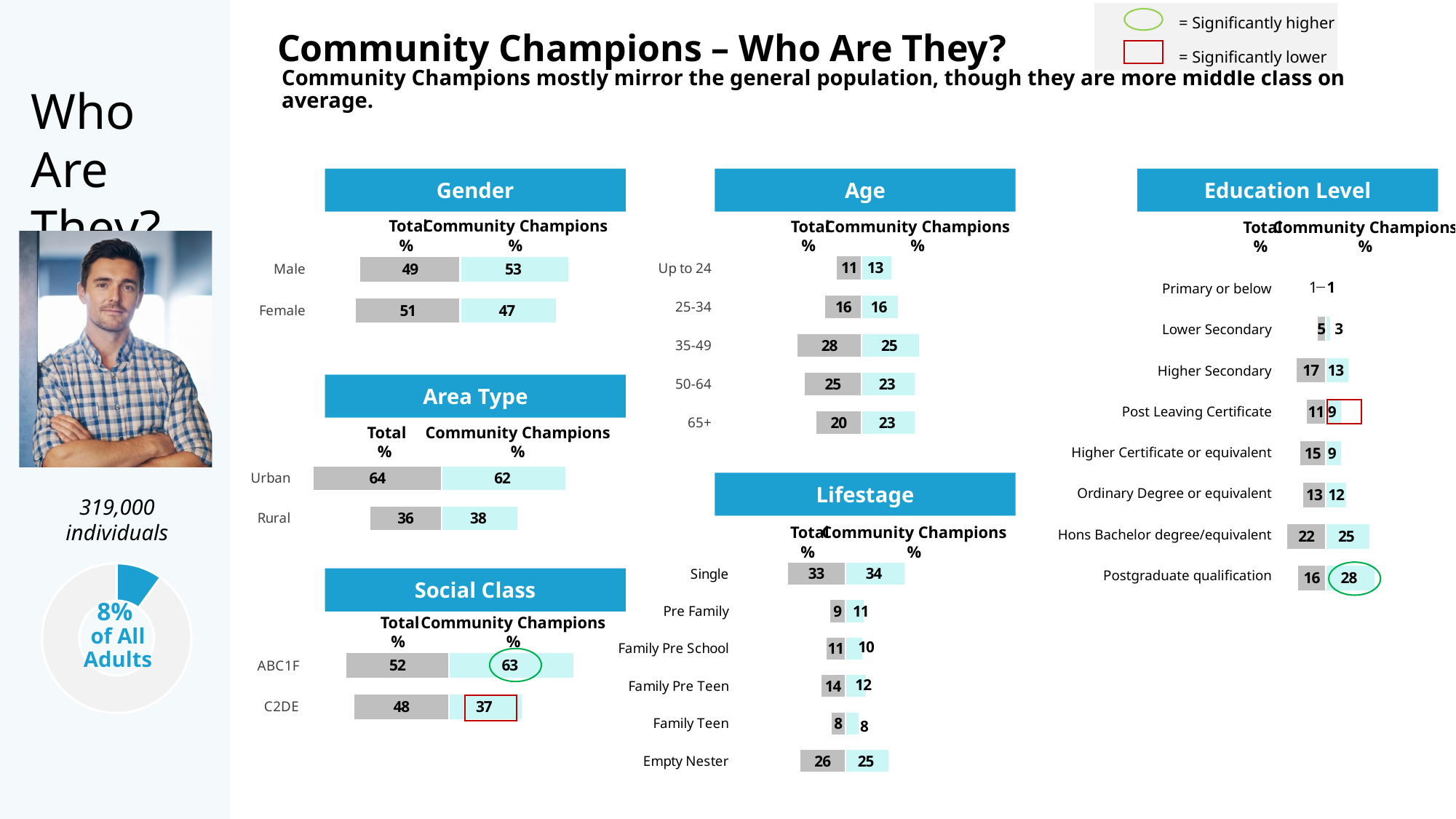
In the Education Level chart, which education level has the highest Community Champions %? Postgraduate qualification In the Lifestage chart, which lifestage has the lowest Total %? Family Teen In the Age chart, which age group has the highest Total %? 35-49 In the Lifestage chart, what is the Community Champions % for Empty Nester? 25 In the Area Type chart, what is the Total % for Urban? 64 In the Education Level chart, what is the Community Champions % for Postgraduate qualification? 28 In the Social Class chart, what is the difference between the Community Champions % and the Total % for ABC1F? 11 In the Social Class chart, which is larger for C2DE: the Total % or the Community Champions %? Total % In the Age chart, how many age groups are shown? 5 What share of all adults does the donut chart on the left show for Community Champions? 8% In the Gender chart, what is the Community Champions % for Male? 53 What kind of chart is used in the Gender panel? Bar chart